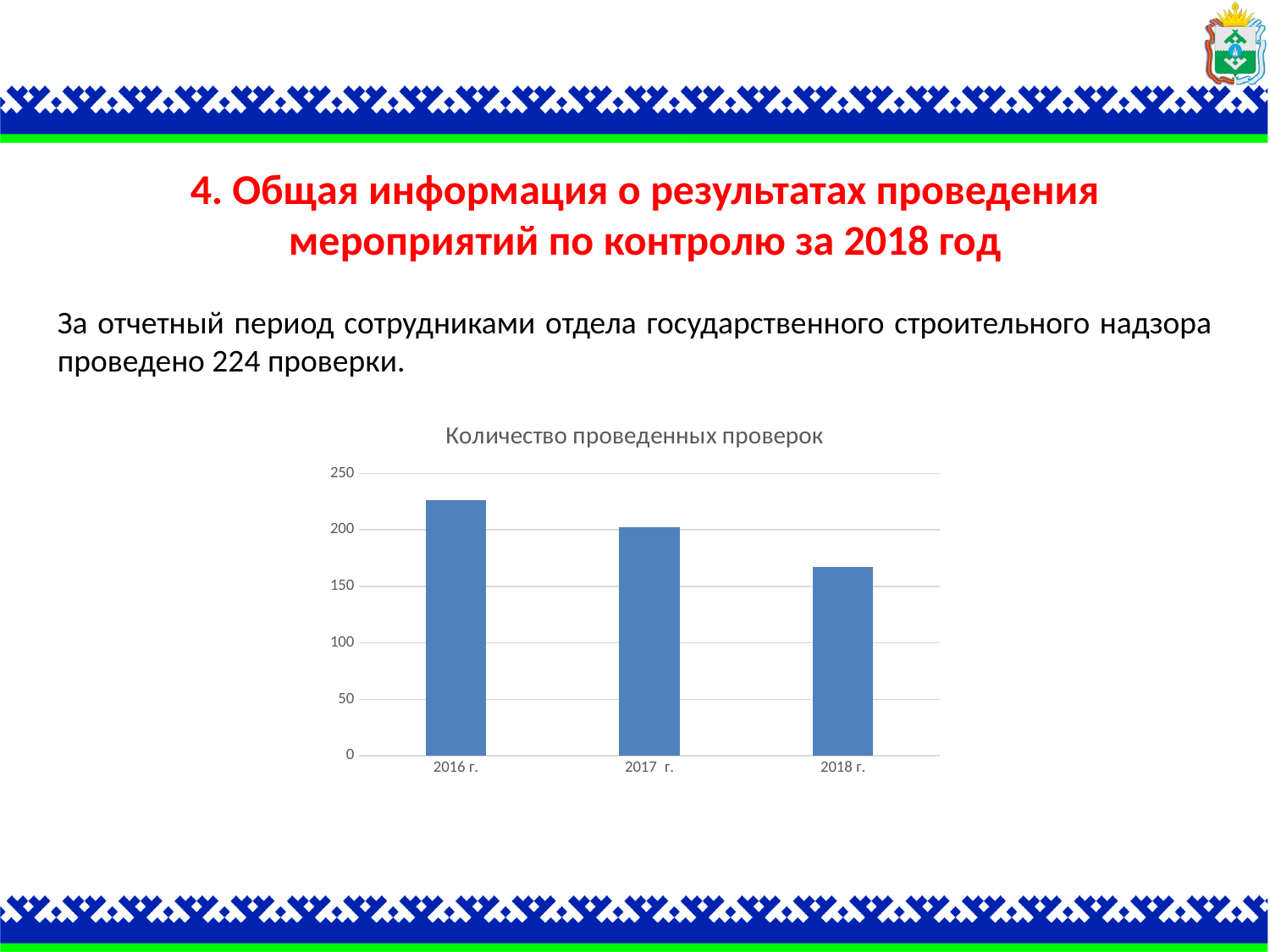
Is the value for 2017 г. greater or less than 250? less What kind of chart is shown on the slide? bar chart Is the value for 2018 г. greater or less than 150? greater Which is larger in the chart, the value for 2016 г. or the value for 2018 г.? 2016 г. Is the value for 2016 г. greater or less than 200? greater Which year has the highest number of проверок in the chart? 2016 г. Do the values in the chart rise or fall from 2016 г. to 2018 г.? fall How many categories (years) are shown on the x axis of the chart? 3 Which year has the lowest number of проверок in the chart? 2018 г. What is the title of the chart? Количество проведенных проверок Which is larger in the chart, the value for 2017 г. or the value for 2018 г.? 2017 г.